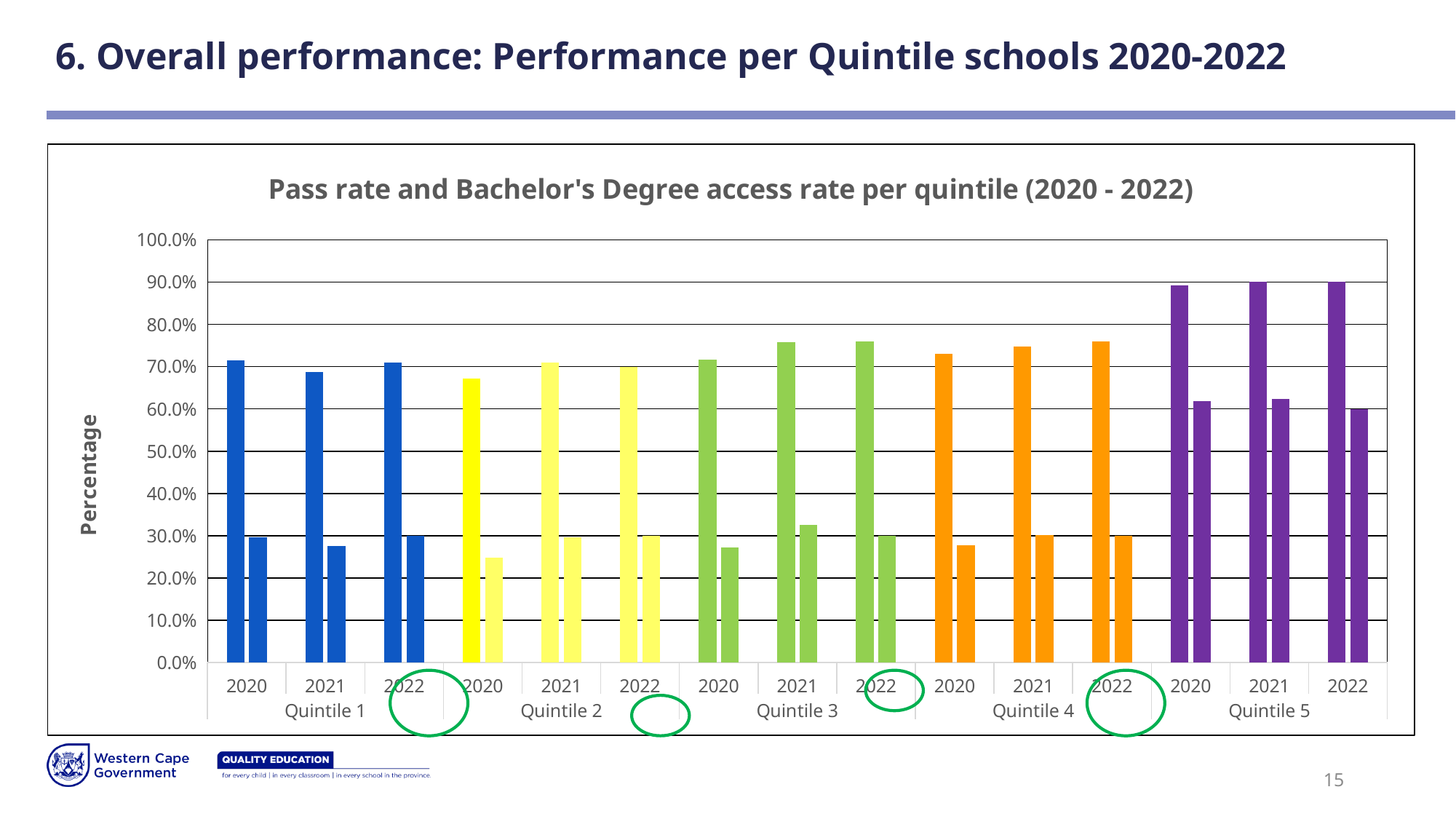
What type of chart is shown on the slide? Bar chart Is the value of the shorter (second) bar for 2020 in Quintile 2 greater or less than 30.0%? less Is the value of the taller (first) bar for 2021 in Quintile 5 greater or less than 80.0%? greater What is the title of the chart? Pass rate and Bachelor's Degree access rate per quintile (2020 - 2022) Is the value of the shorter (second) bar for 2020 in Quintile 5 greater or less than 50.0%? greater Which is larger: the taller (first) bar for 2021 in Quintile 5 or the taller (first) bar for 2021 in Quintile 1? Quintile 5 How many quintile groups are shown along the x axis? 5 What is the label on the vertical axis of the chart? Percentage Which quintile has the tallest bars in the chart? Quintile 5 How many year labels appear along the x axis in total? 15 Do the taller (first) bars for Quintile 3 rise or fall from 2020 to 2022? Rise